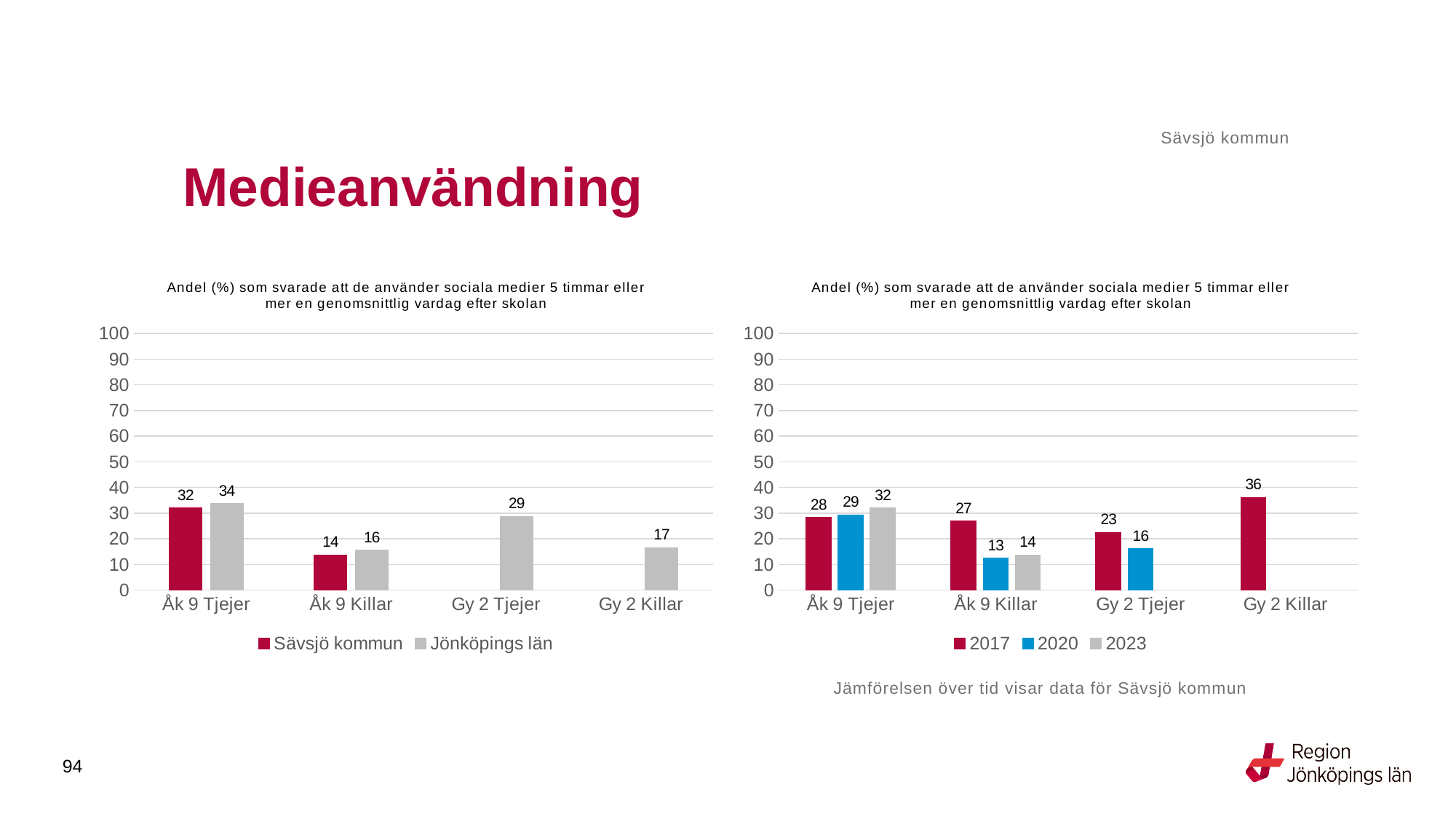
In the left chart, how many series does the legend list? 2 In the right chart, which category has the lowest value for 2017? Gy 2 Tjejer In the right chart, is the 2017 value for Gy 2 Tjejer larger or the 2020 value for Gy 2 Tjejer? 2017 In the left chart, which category has the highest value for Jönköpings län? Åk 9 Tjejer In the left chart, what is the value for Jönköpings län for Åk 9 Tjejer? 34 In the right chart, what is the value for 2020 for Åk 9 Killar? 13 In the right chart, how many series does the legend list? 3 What kind of chart is the right chart? Bar chart In the left chart, what is the value for Sävsjö kommun for Åk 9 Killar? 14 In the right chart, what is the difference between the 2023 and 2017 values for Åk 9 Tjejer? 4 In the left chart, what is the difference between Jönköpings län and Sävsjö kommun for Åk 9 Tjejer? 2 In the right chart, what is the value for 2017 for Gy 2 Killar? 36